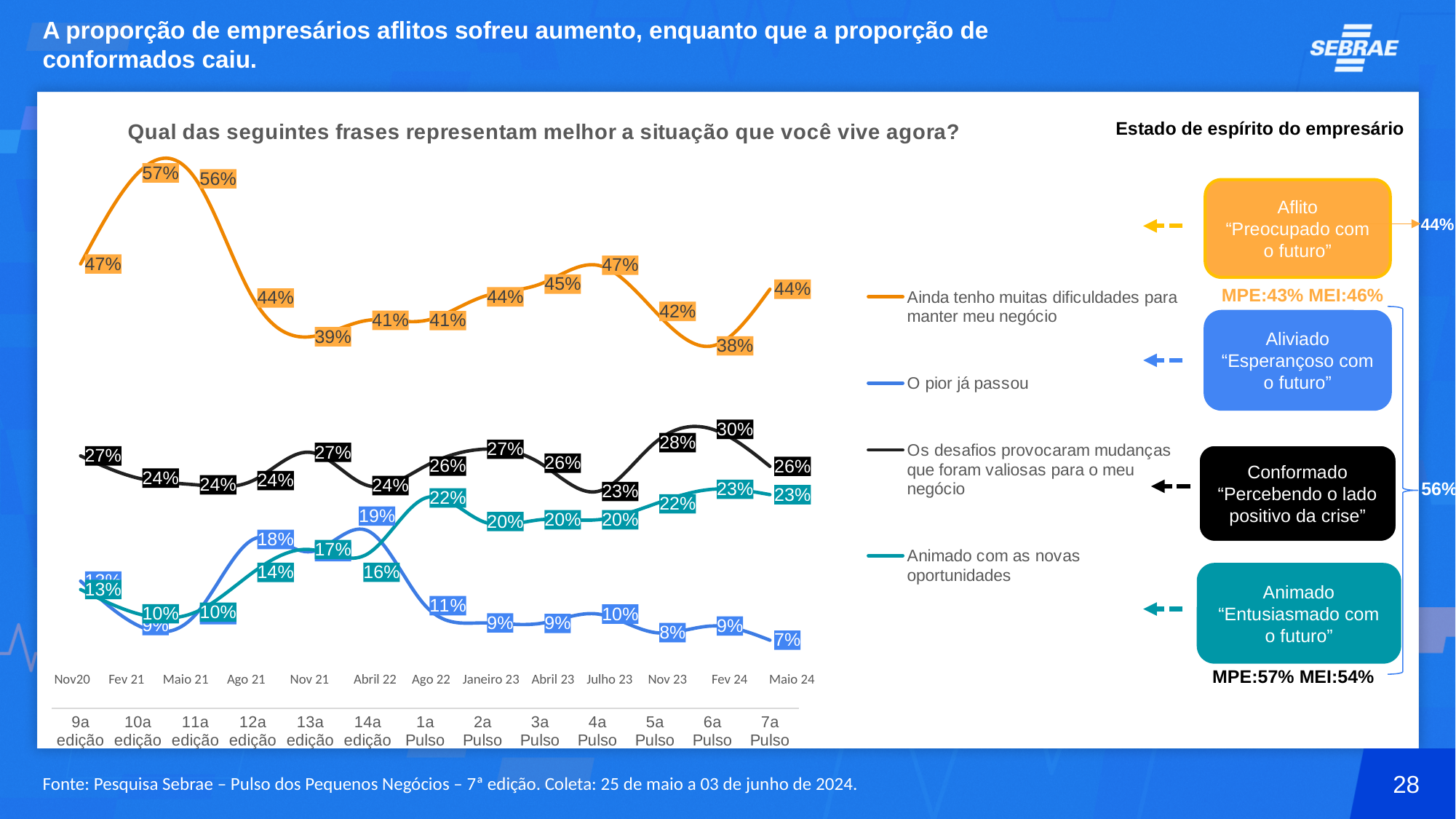
What question is shown as the title of the chart? Qual das seguintes frases representam melhor a situação que você vive agora? At which period does the 'Ainda tenho muitas dificuldades para manter meu negócio' series reach its highest value? Fev 21 (10a edição), 57% At Maio 24, which is larger: 'Os desafios provocaram mudanças que foram valiosas para o meu negócio' or 'Animado com as novas oportunidades'? Os desafios provocaram mudanças que foram valiosas para o meu negócio Does the 'O pior já passou' series rise or fall from Ago 22 (1a Pulso) to Maio 24 (7a Pulso)? Fall What is the value of the 'Animado com as novas oportunidades' series at Maio 24 (7a Pulso)? 23% How many time periods are plotted on the x axis of the chart? 13 By how many percentage points did the 'Ainda tenho muitas dificuldades para manter meu negócio' series change from Fev 24 to Maio 24? 6 percentage points How many series does the chart's legend list? 4 At which period does the 'Ainda tenho muitas dificuldades para manter meu negócio' series reach its lowest value? Fev 24 (6a Pulso), 38% What kind of chart is shown on the slide? Line chart What is the value of the 'Os desafios provocaram mudanças que foram valiosas para o meu negócio' series at Fev 24 (6a Pulso)? 30% What is the value of the 'Ainda tenho muitas dificuldades para manter meu negócio' series at Maio 24 (7a Pulso)? 44%